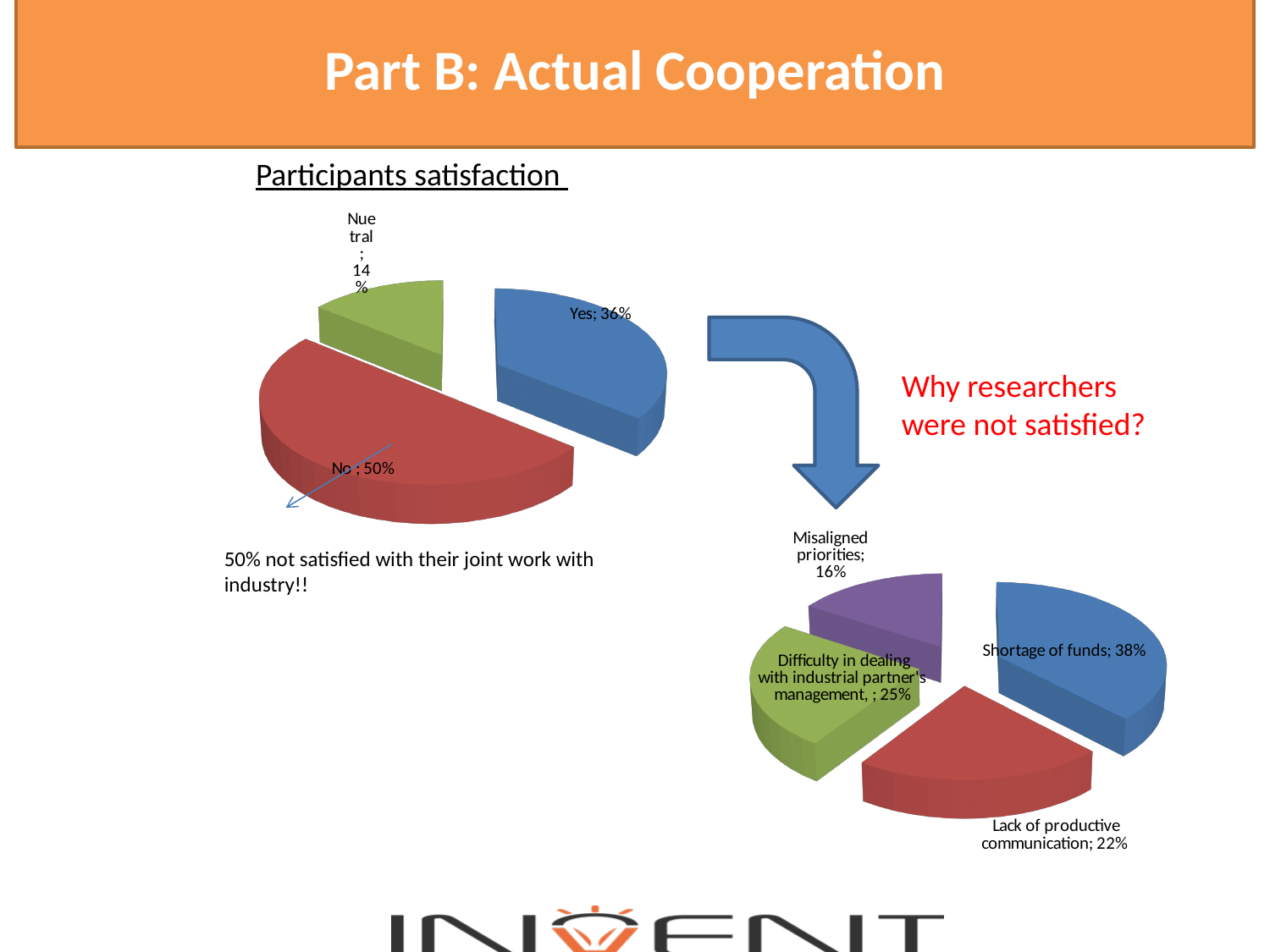
In the Participants satisfaction pie chart, what share of participants answered No? 50% In the lower-right pie chart on why researchers were not satisfied, which is larger: Difficulty in dealing with industrial partner's management or Lack of productive communication? Difficulty in dealing with industrial partner's management In the Participants satisfaction pie chart, which response has the smallest slice? Neutral What type of chart is used for Participants satisfaction? Pie chart In the lower-right pie chart on why researchers were not satisfied, which reason has the smallest share? Misaligned priorities In the lower-right pie chart on why researchers were not satisfied, what share is attributed to Shortage of funds? 38% In the lower-right pie chart on why researchers were not satisfied, what share is attributed to Lack of productive communication? 22% How many slices does the Participants satisfaction pie chart have? 3 In the Participants satisfaction pie chart, which response has the largest slice? No In the Participants satisfaction pie chart, what share of participants answered Yes? 36% In the Participants satisfaction pie chart, what share of participants were Neutral? 14% In the Participants satisfaction pie chart, what is the difference between the No and Yes shares? 14%